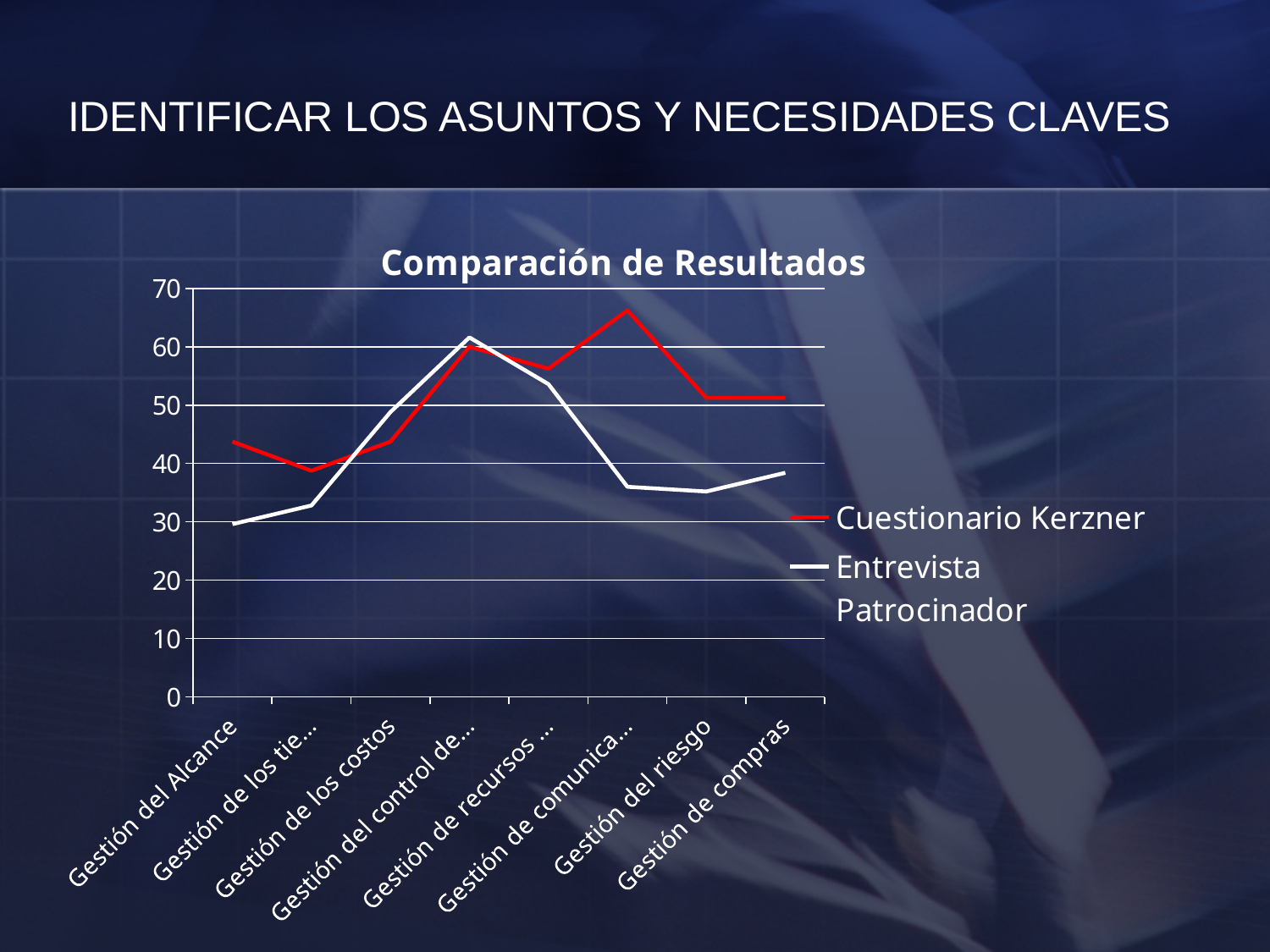
Which category has the lowest Entrevista Patrocinador value? Gestión del Alcance Which category has the highest Cuestionario Kerzner value? Gestión de comunica... For Gestión del Alcance, which series has the higher value, Cuestionario Kerzner or Entrevista Patrocinador? Cuestionario Kerzner How many series does the chart legend list? 2 Is the Entrevista Patrocinador value for Gestión del riesgo greater or less than 40? less Does the Entrevista Patrocinador line rise or fall from Gestión del Alcance to Gestión de los costos? rise Is the Entrevista Patrocinador value for Gestión de compras greater or less than 50? less Which colour is used for the Cuestionario Kerzner line? red How many categories are plotted along the x axis of the chart? 8 What kind of chart is shown on the slide? line chart Is the Cuestionario Kerzner value for Gestión del riesgo greater or less than 40? greater What is the title of the chart? Comparación de Resultados